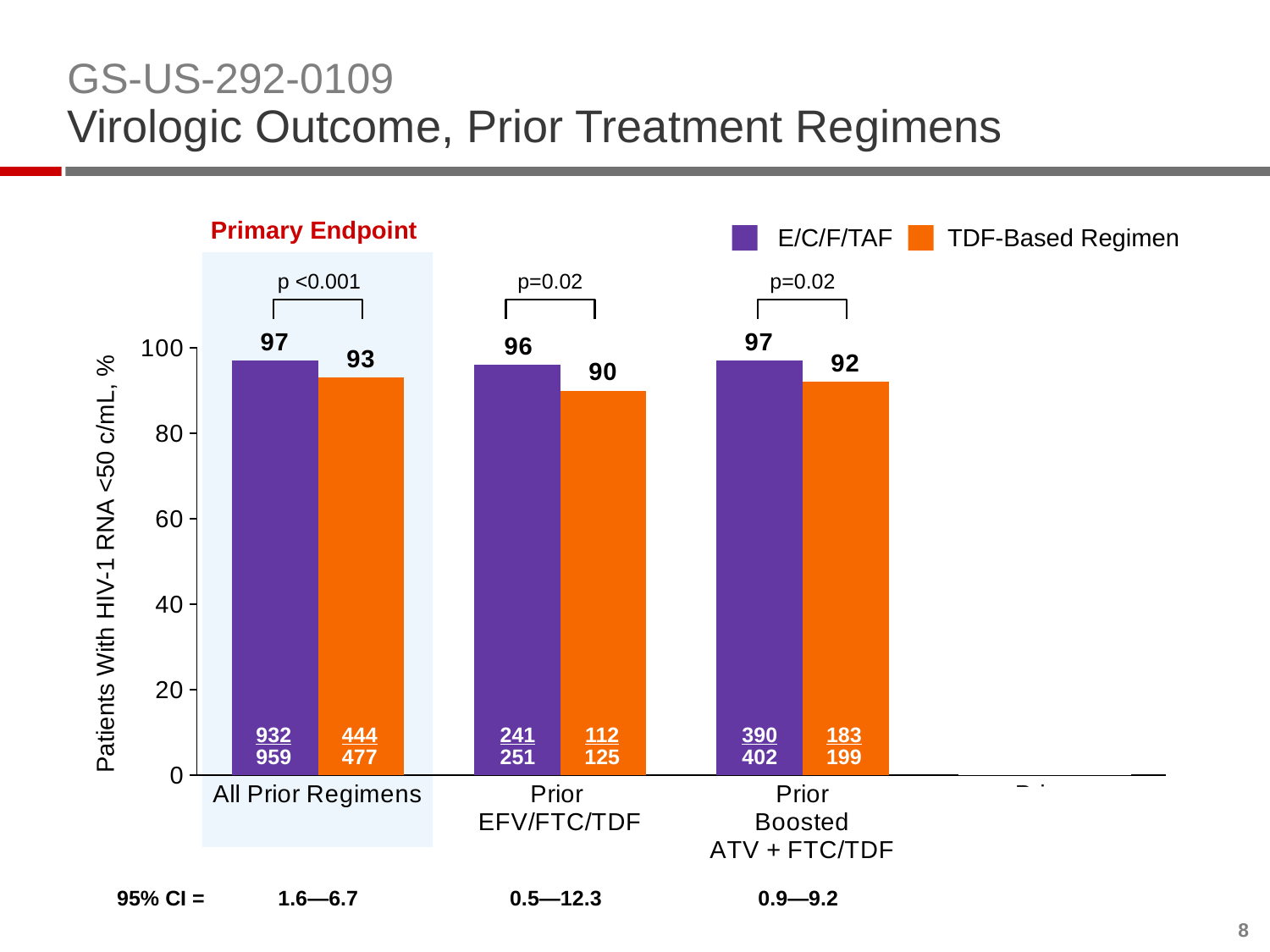
How many series does the legend list? 2 What is the difference between the E/C/F/TAF and TDF-Based Regimen values in the All Prior Regimens category? 4 What kind of chart is shown on the slide? Bar chart Which is larger in the Prior Boosted ATV + FTC/TDF category: E/C/F/TAF or the TDF-Based Regimen? E/C/F/TAF What is the value for the TDF-Based Regimen in the Prior Boosted ATV + FTC/TDF category? 92 What is the difference between the E/C/F/TAF and TDF-Based Regimen values in the Prior EFV/FTC/TDF category? 6 What is the value for E/C/F/TAF in the Prior EFV/FTC/TDF category? 96 What is the value for E/C/F/TAF in the All Prior Regimens category? 97 What is the p-value shown above the All Prior Regimens bars? p <0.001 What is the value for the TDF-Based Regimen in the Prior EFV/FTC/TDF category? 90 In which category is the TDF-Based Regimen value lowest? Prior EFV/FTC/TDF Which category is highlighted as the Primary Endpoint? All Prior Regimens